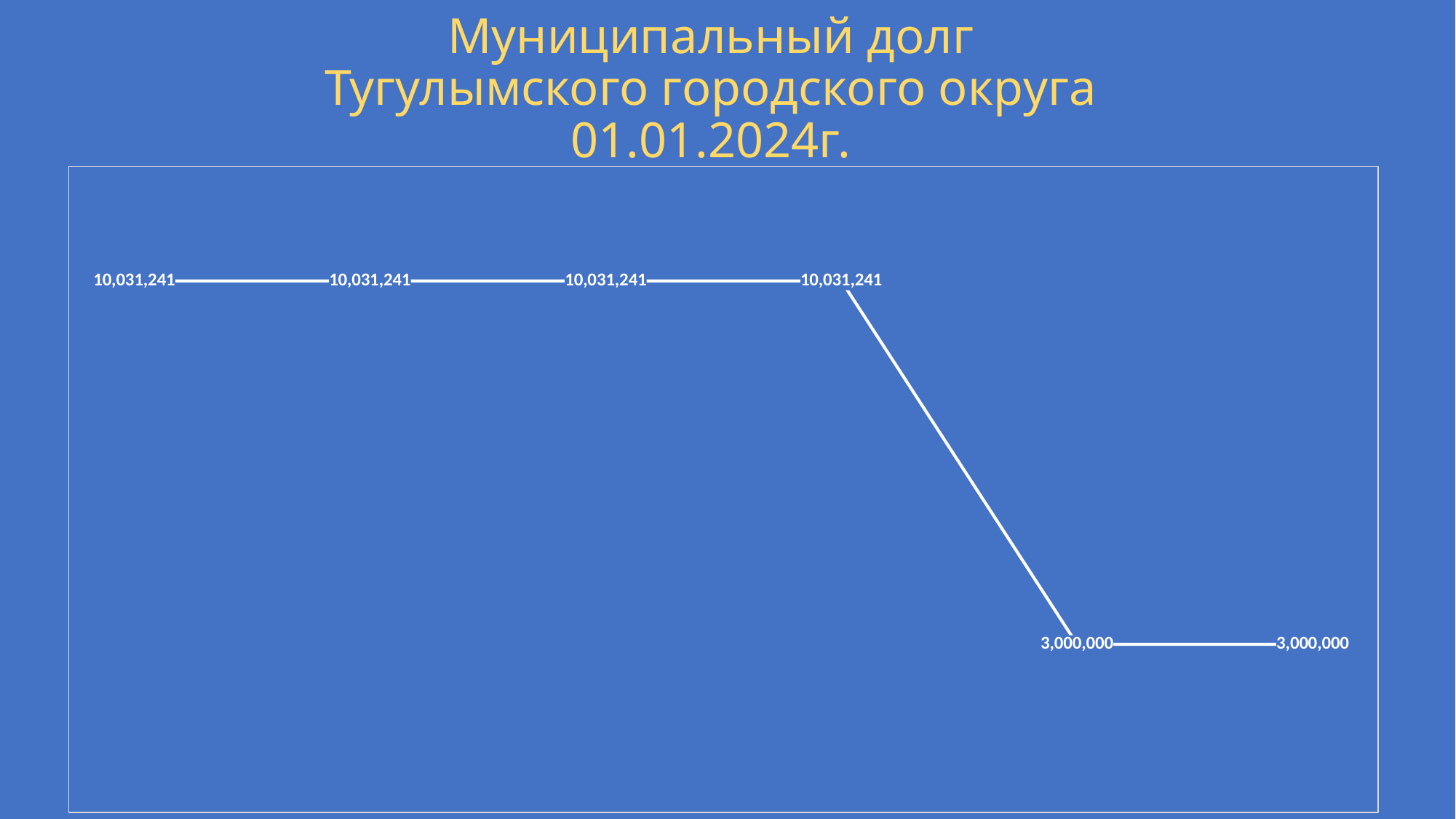
What is the highest value shown on the chart? 10,031,241 What is the value of the last (rightmost) point on the line? 3,000,000 What kind of chart is shown on the slide? line chart What is the difference between the highest and lowest values on the chart? 7,031,241 Do the values rise or fall from left to right along the line? fall How many points on the line have the value 10,031,241? 4 How many data points are plotted on the line? 6 What is the lowest value shown on the chart? 3,000,000 What is the value of the first (leftmost) point on the line? 10,031,241 What is the title of the slide? Муниципальный долг Тугулымского городского округа 01.01.2024г. How many points on the line have the value 3,000,000? 2 Is the first point's value larger or smaller than the last point's value? larger